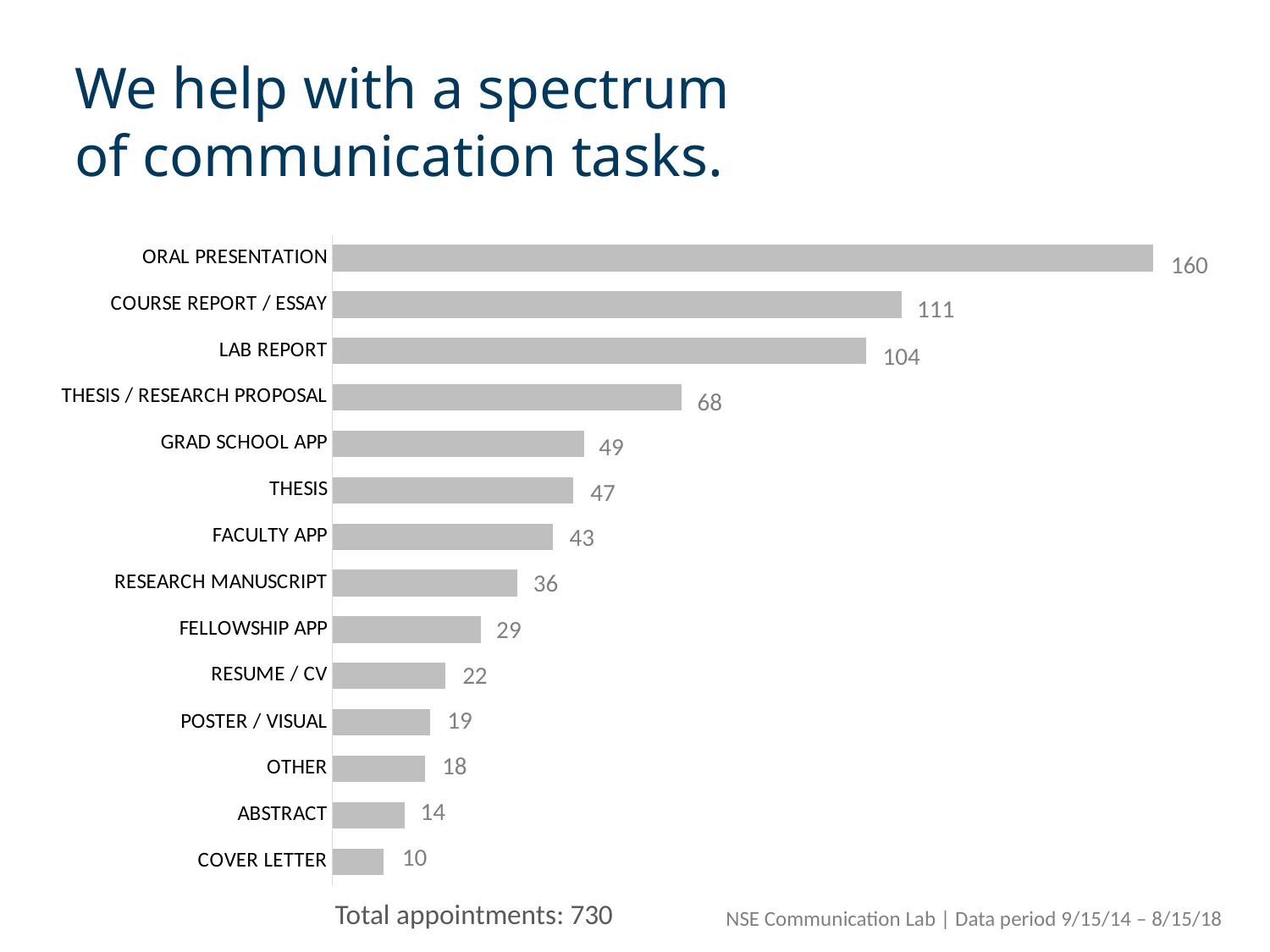
Which category has the highest value? ORAL PRESENTATION What is the value for ORAL PRESENTATION? 160 What is the difference between the values for ORAL PRESENTATION and COURSE REPORT / ESSAY? 49 How many categories are shown in the chart? 14 Which is larger, the value for GRAD SCHOOL APP or the value for FACULTY APP? GRAD SCHOOL APP What kind of chart is shown on the slide? bar chart What is the difference between the values for THESIS / RESEARCH PROPOSAL and THESIS? 21 What is the value for LAB REPORT? 104 What is the value for FELLOWSHIP APP? 29 What data period is stated on the slide? 9/15/14 – 8/15/18 What total number of appointments is stated below the chart? 730 Which category has the lowest value? COVER LETTER